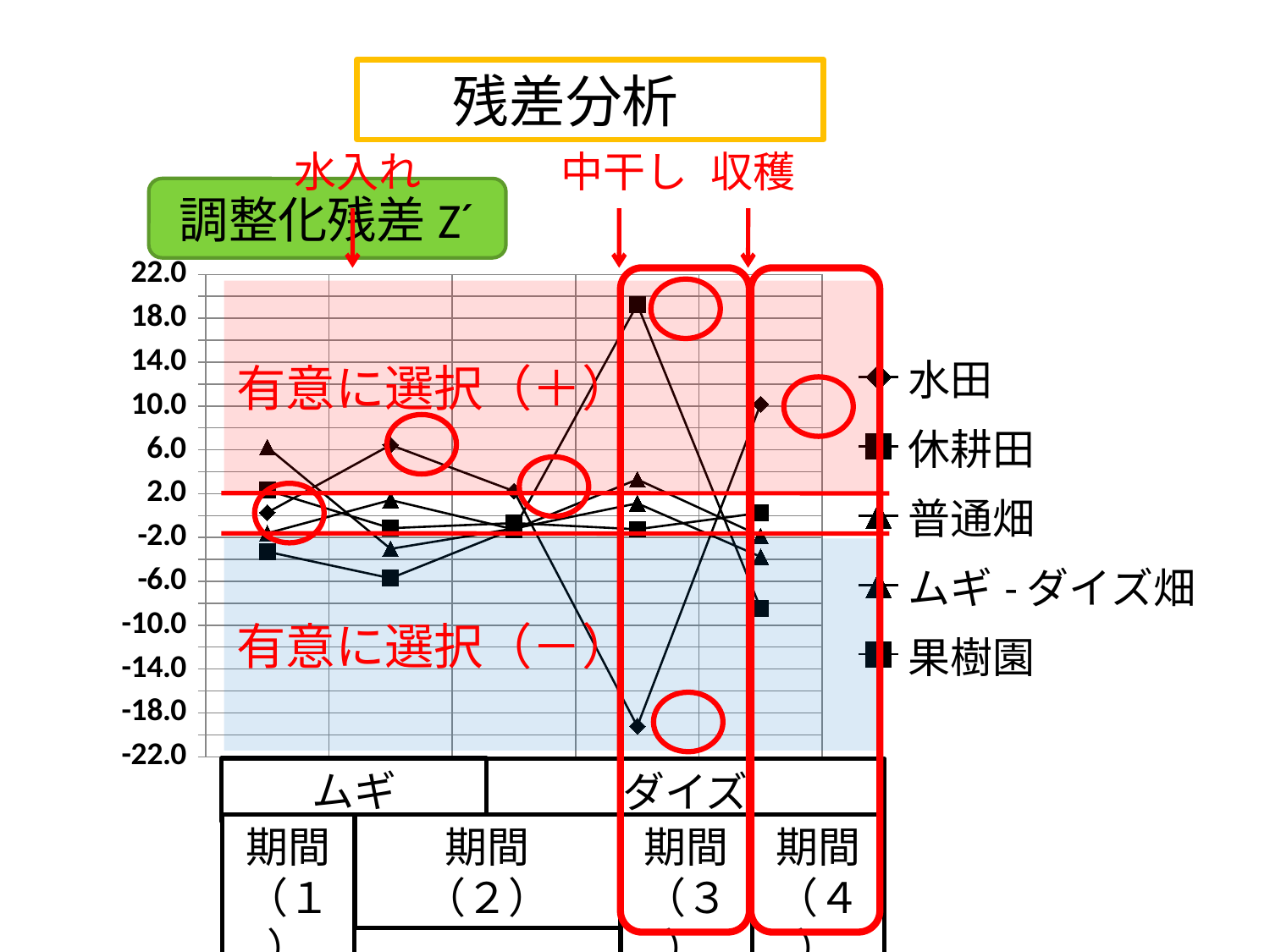
Is the value for 休耕田 in 期間(3) greater or less than 14.0? greater Which series has the highest value in 期間(3)? 休耕田 How many 期間 (period) categories are shown along the x axis? 4 Is the value for 水田 in 期間(3) greater or less than -14.0? less What is the highest value shown on the y axis? 22.0 What kind of chart is shown on the slide? line chart Which series has the lowest value in 期間(3)? 水田 In 期間(3), which series has the larger value, 休耕田 or 水田? 休耕田 How many series does the chart legend list? 5 What is the first entry listed in the chart legend? 水田 Is the value for 水田 in 期間(4) greater or less than 6.0? greater